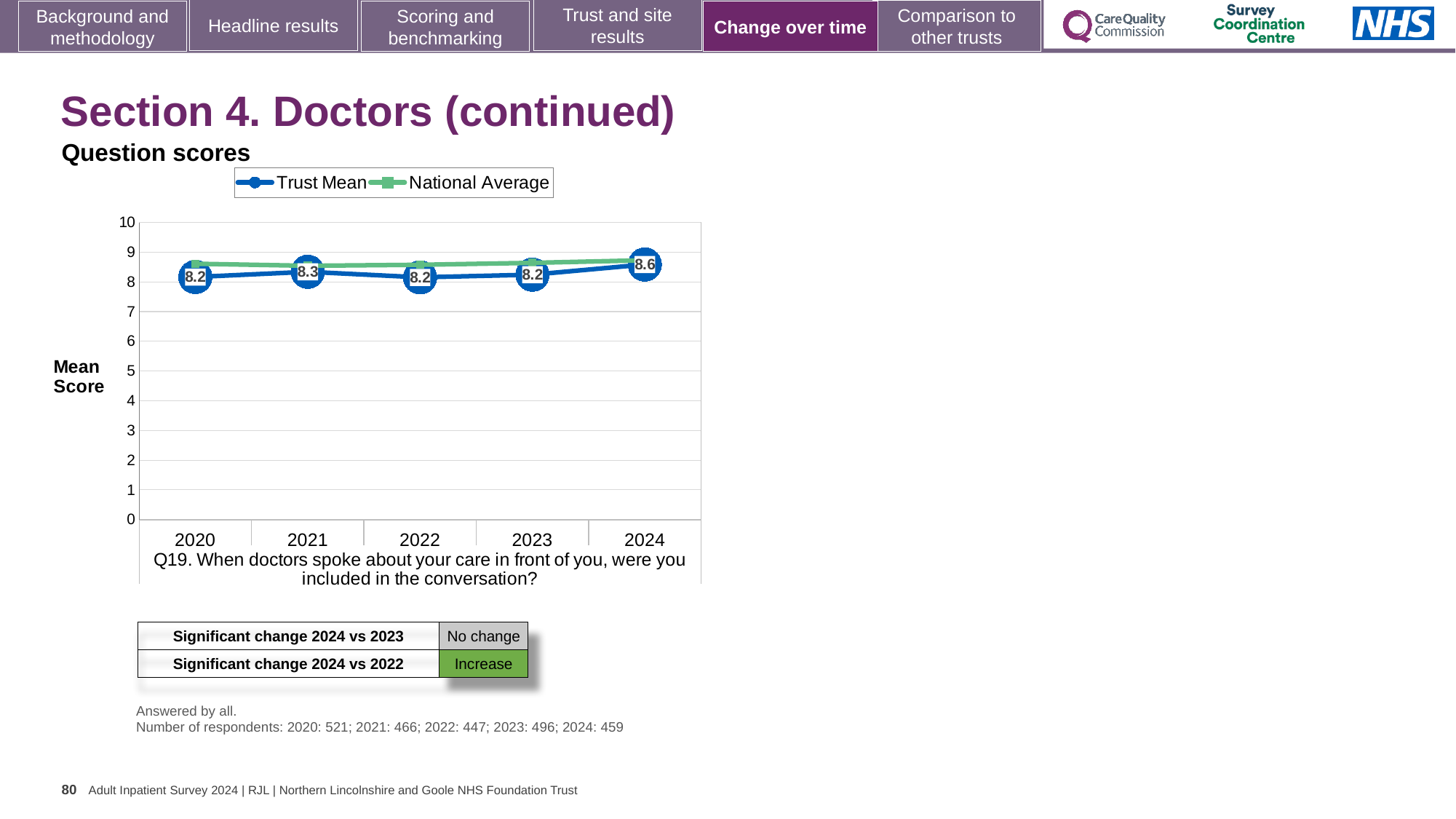
What are the two series named in the legend? Trust Mean and National Average What is the difference between the Trust Mean scores for 2024 and 2023? 0.4 How many series does the legend list? 2 How many years are plotted on the x axis? 5 Which year has the larger Trust Mean score, 2021 or 2022? 2021 What kind of chart is shown on the slide? Line chart What is the Trust Mean score for 2020? 8.2 Does the Trust Mean score rise or fall from 2023 to 2024? Rise What is the Trust Mean score for 2021? 8.3 In which year is the Trust Mean score highest? 2024 What is the Trust Mean score for 2024? 8.6 Is the National Average value for 2020 greater or less than 8? greater